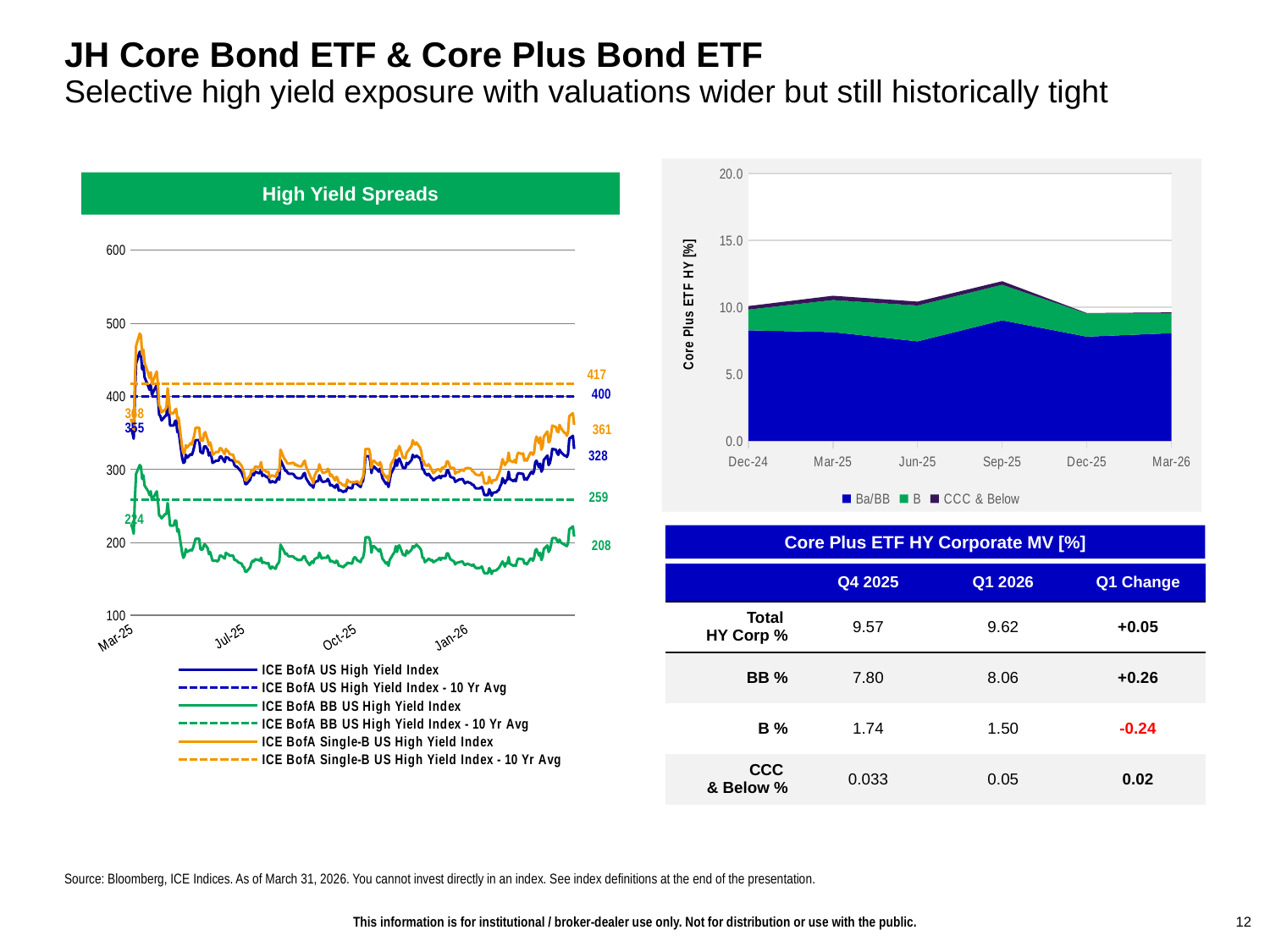
In the "High Yield Spreads" chart, how far below its 10 Yr Avg of 400 is the latest ICE BofA US High Yield Index value of 328? 72 In the "High Yield Spreads" chart, which has the higher latest value: the ICE BofA Single-B US High Yield Index or the ICE BofA US High Yield Index? ICE BofA Single-B US High Yield Index In the "Core Plus ETF HY [%]" chart, is the Ba/BB value at Sep-25 greater or less than 5.0? greater How many series does the legend of the "High Yield Spreads" chart list? 6 In the "High Yield Spreads" chart, what is the difference between the Single-B 10 Yr Avg (417) and the US High Yield 10 Yr Avg (400)? 17 In the "High Yield Spreads" chart, what is the labelled value of the ICE BofA Single-B US High Yield Index - 10 Yr Avg line? 417 In the "High Yield Spreads" chart, what is the latest labelled value of the ICE BofA BB US High Yield Index? 208 What kind of chart is the "High Yield Spreads" chart on the left? Line chart How many date labels are shown on the x axis of the "Core Plus ETF HY [%]" chart? 6 What kind of chart is the "Core Plus ETF HY [%]" chart on the right? Stacked area chart In the "High Yield Spreads" chart, what is the latest labelled value of the ICE BofA US High Yield Index? 328 How many series does the legend of the "Core Plus ETF HY [%]" chart list? 3